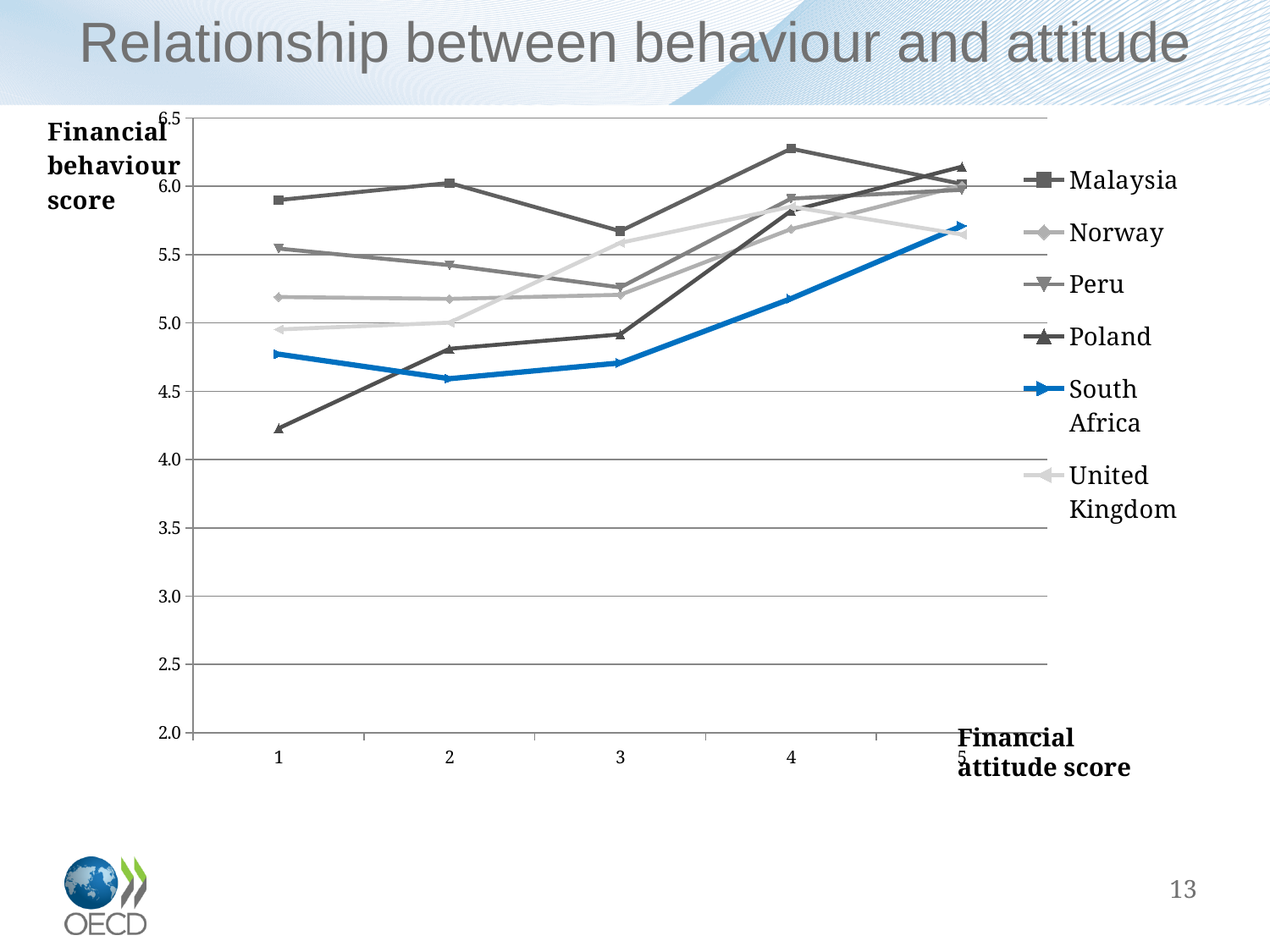
Which country has the highest financial behaviour score at a financial attitude score of 1? Malaysia How many series does the legend list? 6 Is the value for Malaysia at a financial attitude score of 4 greater or less than 6.0? greater Which country has the lowest financial behaviour score at a financial attitude score of 1? Poland Is the value for South Africa at a financial attitude score of 5 greater or less than 5.5? greater Is the value for Poland at a financial attitude score of 1 greater or less than 4.5? less At a financial attitude score of 2, which is larger: the value for Malaysia or the value for South Africa? Malaysia How many financial attitude score points are plotted along the x axis? 5 What is the label of the vertical axis? Financial behaviour score Does the Poland line rise or fall as the financial attitude score increases from 1 to 5? rise Which country has the lowest financial behaviour score at a financial attitude score of 4? South Africa What kind of chart is shown on the slide? line chart